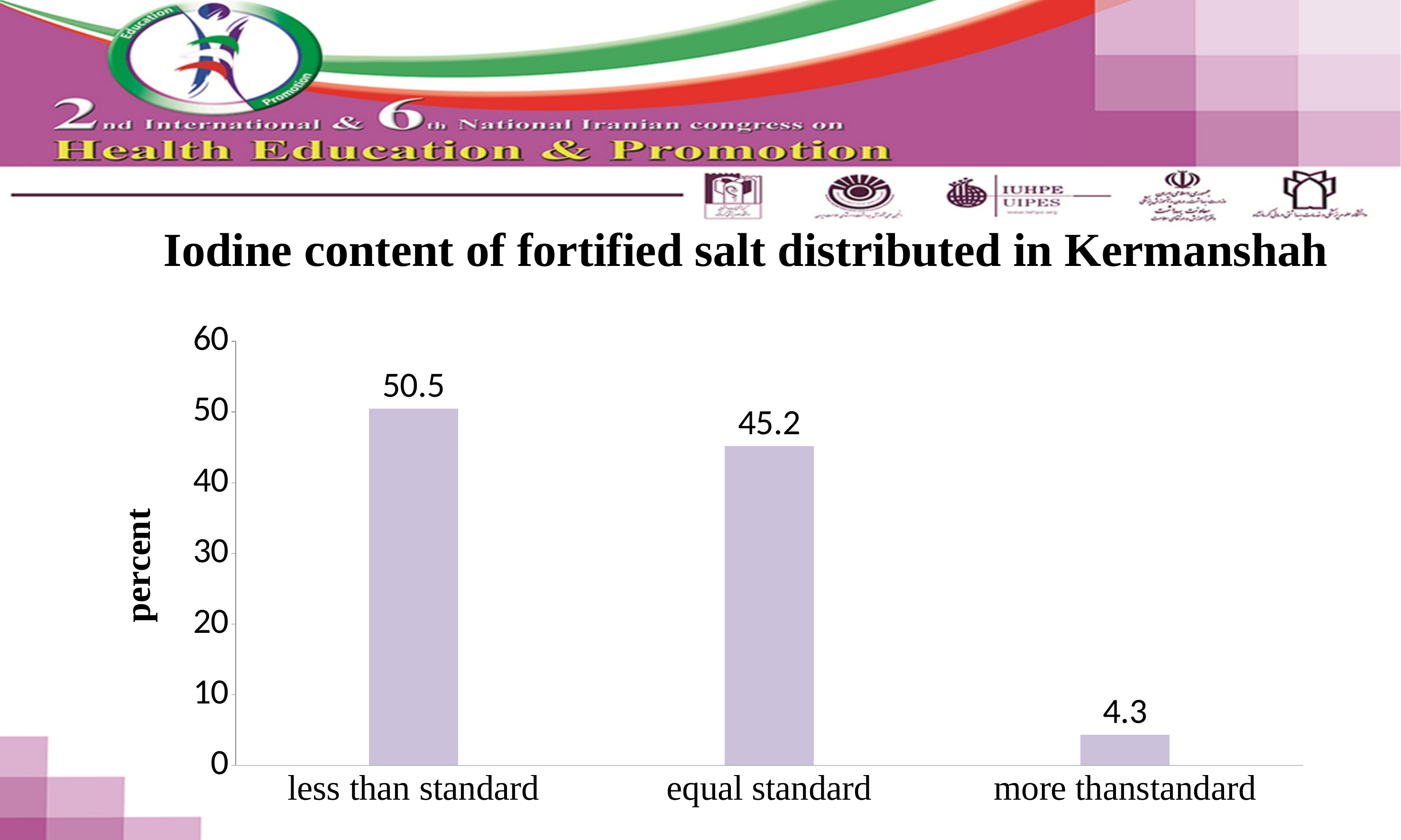
Is the value for "equal standard" greater or less than 40? greater What is the label of the vertical axis? percent What is the value for "less than standard"? 50.5 What kind of chart is shown on the slide? bar chart What is the difference between the values for "equal standard" and "more than standard"? 40.9 How many categories are shown on the x axis? 3 What is the value for "equal standard"? 45.2 Which category has the lowest value? more than standard Which category has the highest value? less than standard What is the difference between the values for "less than standard" and "equal standard"? 5.3 What is the value for "more than standard"? 4.3 Which is larger, the value for "less than standard" or "more than standard"? less than standard